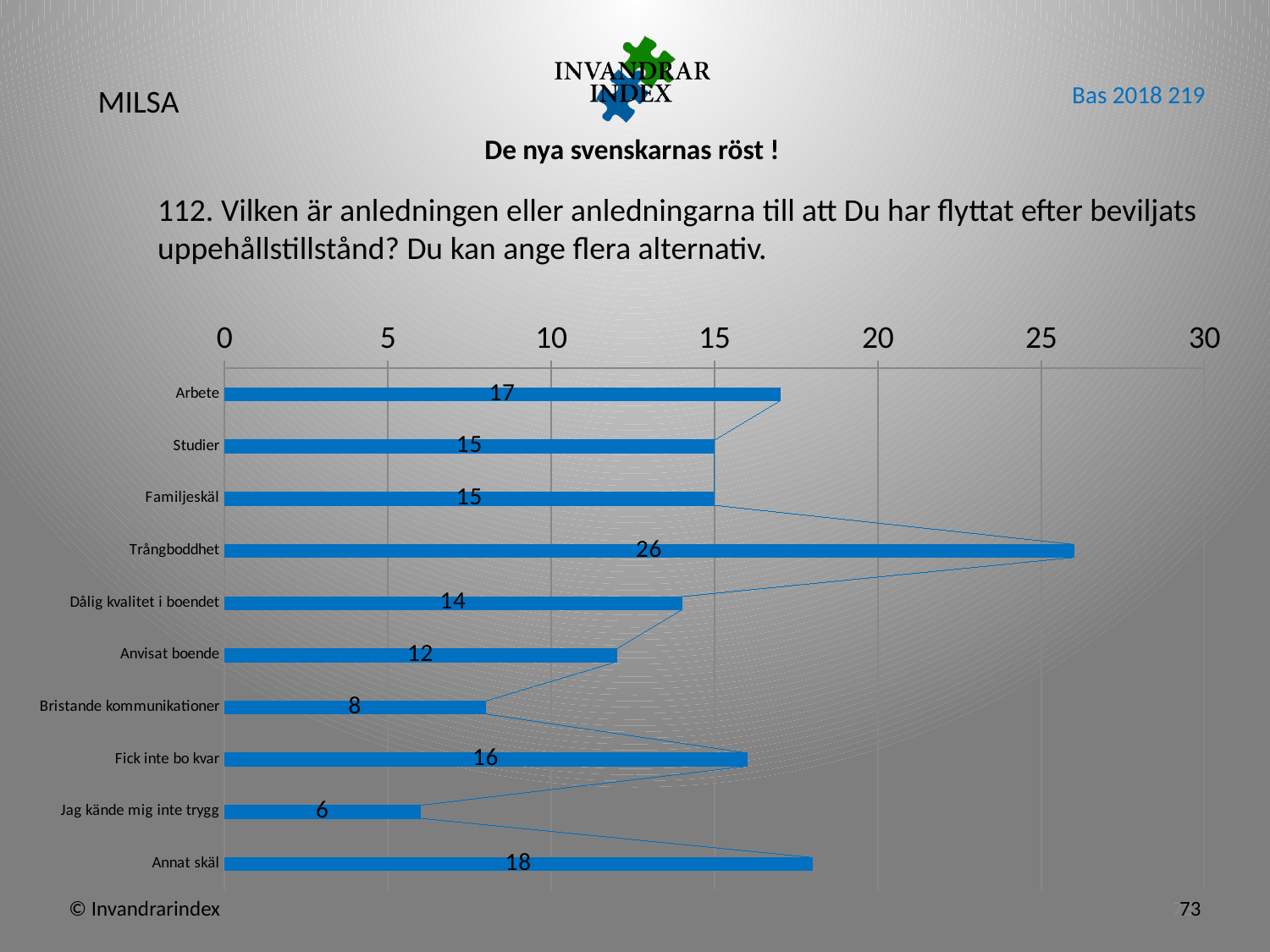
Is the value for Dålig kvalitet i boendet greater or less than 10? greater What is the value for Trångboddhet? 26 What kind of chart is shown on the slide? bar chart What is the value for Annat skäl? 18 How many categories are shown in the chart? 10 What is the value for Studier? 15 What is the difference between the values for Annat skäl and Jag kände mig inte trygg? 12 Which category has the highest value? Trångboddhet Which is larger, the value for Fick inte bo kvar or the value for Anvisat boende? Fick inte bo kvar Which category has the lowest value? Jag kände mig inte trygg What is the value for Bristande kommunikationer? 8 What is the difference between the values for Trångboddhet and Arbete? 9